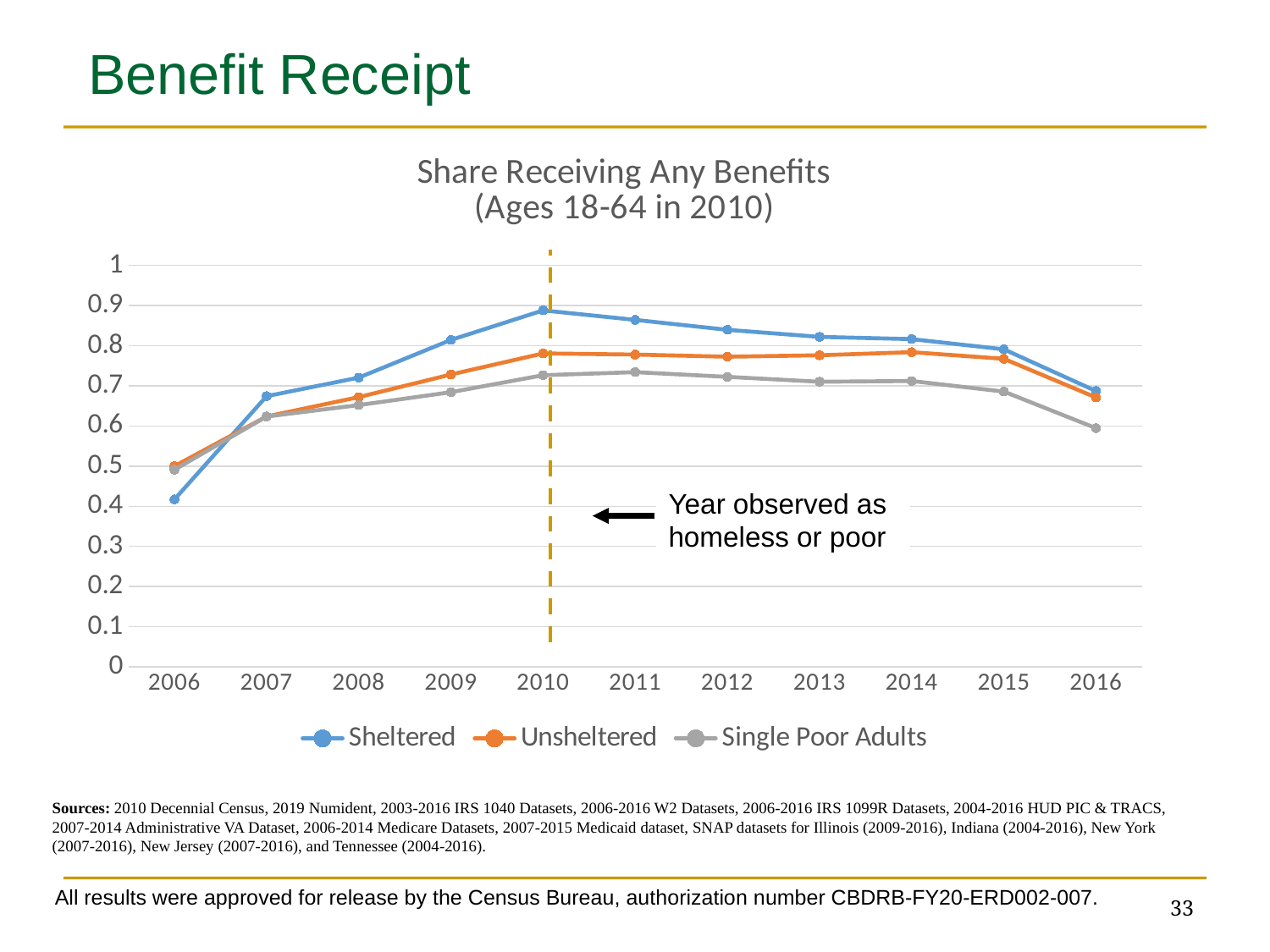
How many years are plotted along the x axis? 11 In 2010, which series has the larger value, Sheltered or Single Poor Adults? Sheltered In which year is the Single Poor Adults series at its lowest value? 2006 Is the value for Single Poor Adults in 2016 greater or less than 0.7? less Is the value for Sheltered in 2010 greater or less than 0.8? greater How many series does the legend list? 3 In which year does the Sheltered series reach its highest value? 2010 In 2006, which series has the larger value, Sheltered or Unsheltered? Unsheltered Is the value for Sheltered in 2006 greater or less than 0.5? less In which year is the Sheltered series at its lowest value? 2006 Does the Sheltered series rise or fall from 2006 to 2010? Rise What kind of chart is shown on the slide? Line chart